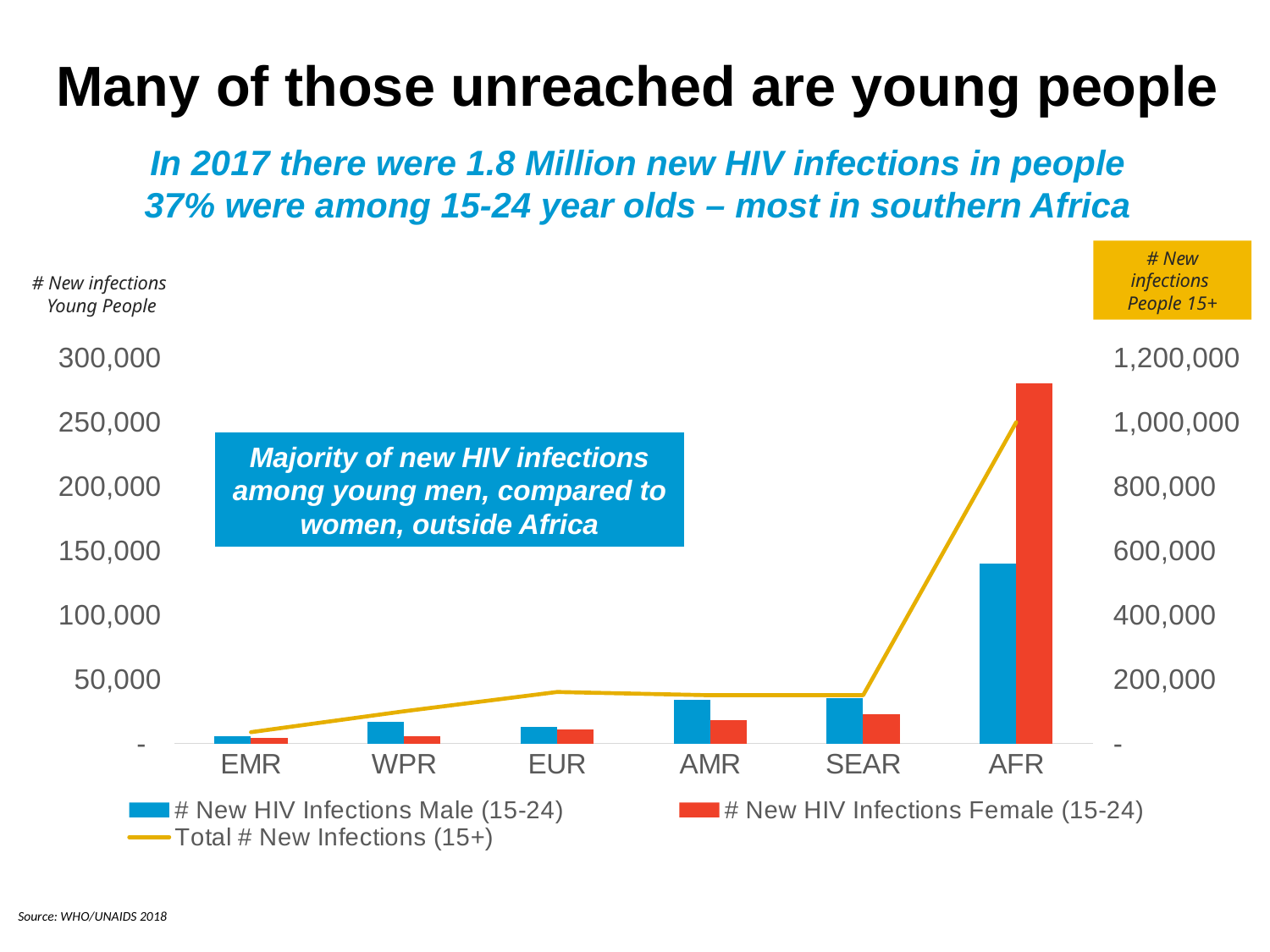
Does the Total # New Infections (15+) line rise or fall from SEAR to AFR? rise What kind of chart is shown on the slide? Bar chart with a line Is the total number of new infections (15+) in AFR greater or less than 800,000 on the right axis? greater In AFR, which is larger: new HIV infections among males (15-24) or females (15-24)? Females (15-24) Which region has the highest number of new HIV infections among females aged 15-24? AFR Is the number of new HIV infections among males (15-24) in AFR greater or less than 100,000? greater How many series does the chart's legend list? 3 In AMR, which is larger: new HIV infections among males (15-24) or females (15-24)? Males (15-24) Is the number of new HIV infections among females (15-24) in AFR greater or less than 250,000? greater How many regions are shown on the x axis of the chart? 6 What is the label of the right-hand axis of the chart? # New infections People 15+ Which region has the highest number of new HIV infections among males aged 15-24? AFR